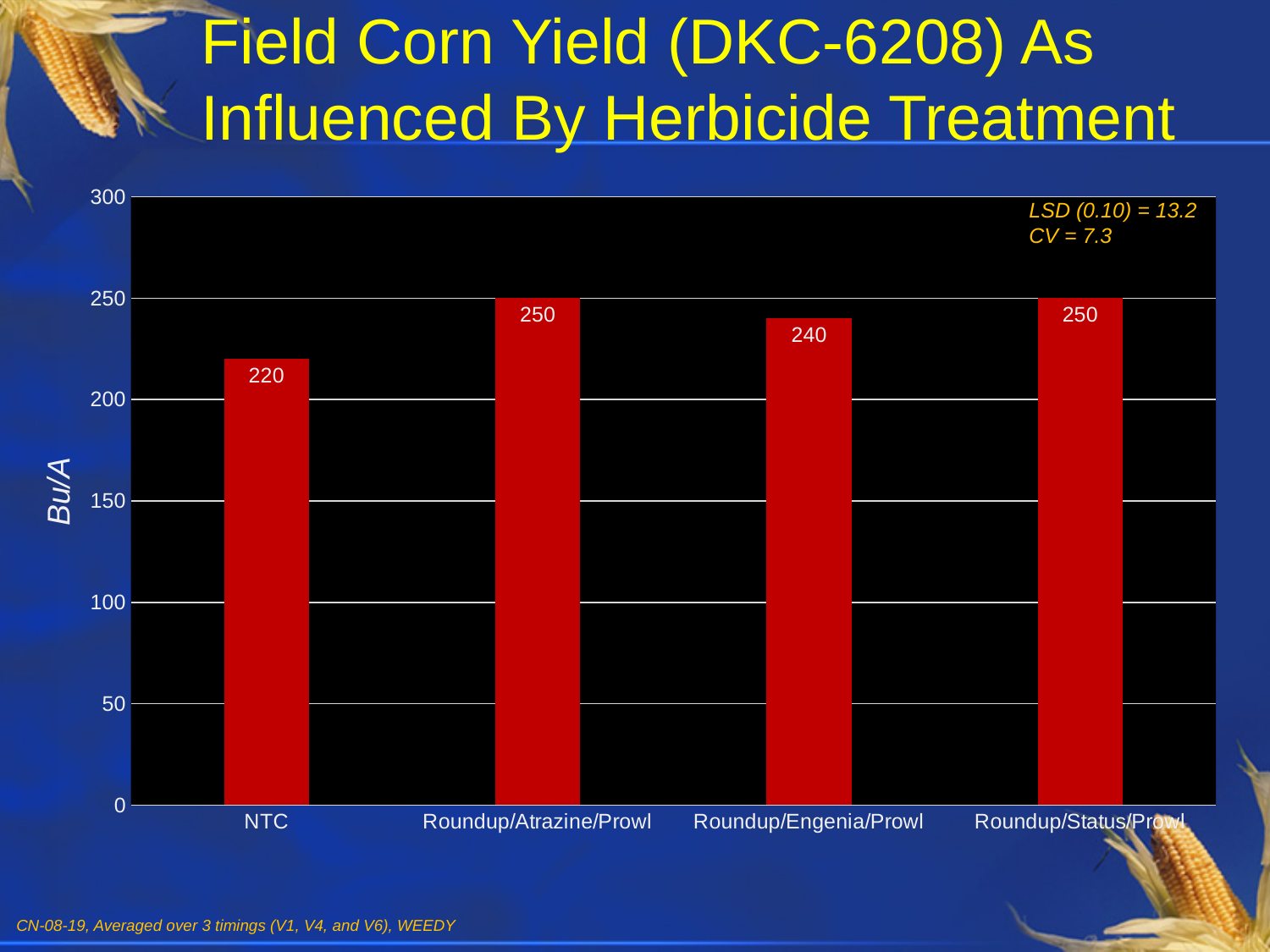
What is the LSD (0.10) value shown on the chart? 13.2 What kind of chart is shown on the slide? bar chart Which has a higher yield, NTC or Roundup/Engenia/Prowl? Roundup/Engenia/Prowl What is the yield for Roundup/Atrazine/Prowl? 250 Which treatment has the lowest yield? NTC What is the difference in yield between Roundup/Status/Prowl and Roundup/Engenia/Prowl? 10 What is the yield for NTC? 220 How many treatments are shown in the chart? 4 What is the yield for Roundup/Engenia/Prowl? 240 What is the label on the y axis? Bu/A What is the difference in yield between Roundup/Atrazine/Prowl and NTC? 30 Is the yield for NTC greater or less than 250? less